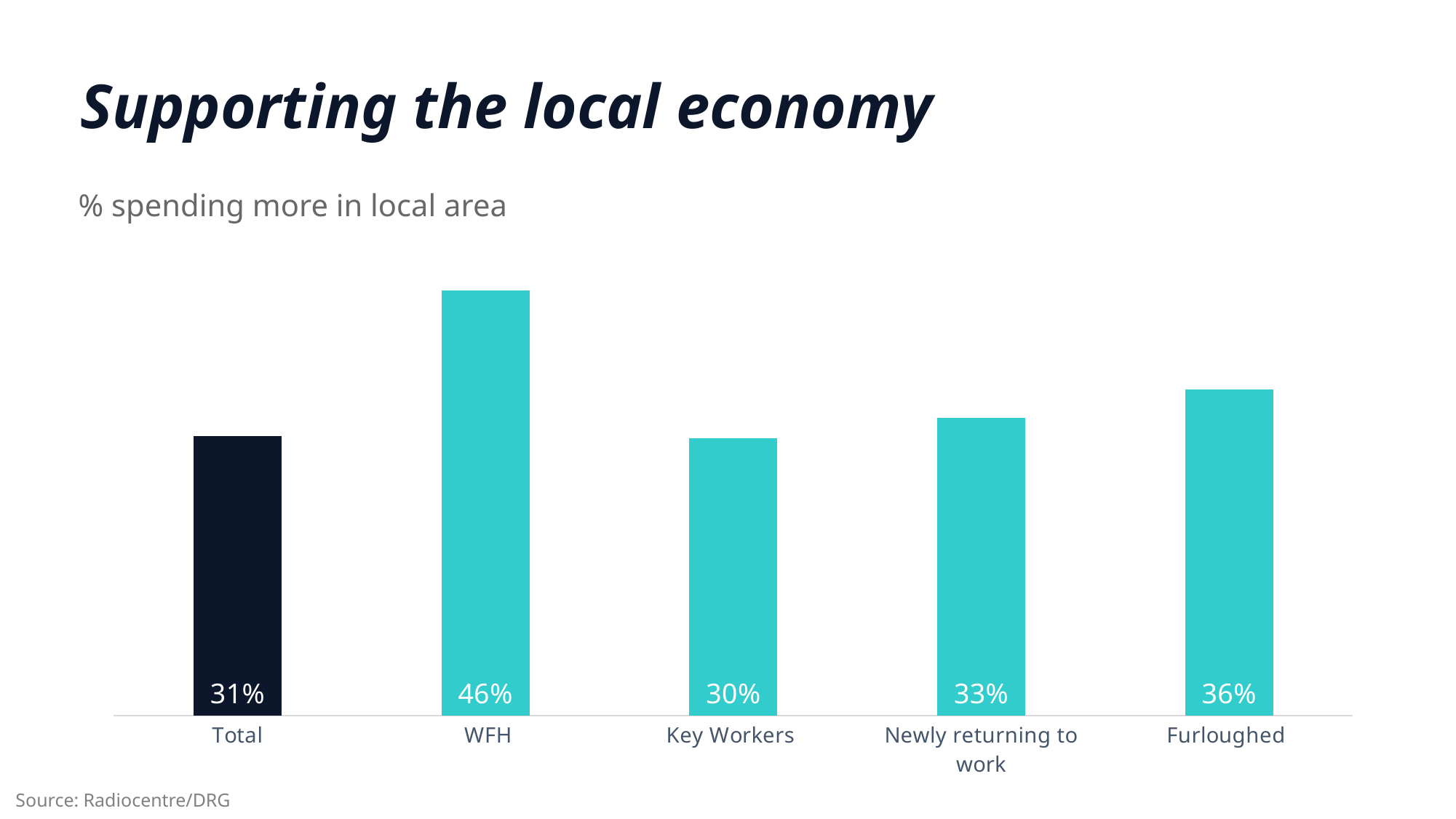
What is the value shown for Furloughed? 36% What is the difference in percentage points between WFH and Key Workers? 16 What type of chart is shown on the slide? Bar chart What is the difference in percentage points between Furloughed and Total? 5 Which is larger, the value for Furloughed or the value for Newly returning to work? Furloughed Which category has the lowest percentage spending more in the local area? Key Workers How many categories are shown on the chart? 5 What is the value shown for Newly returning to work? 33% What percentage of the Total group are spending more in their local area? 31% What is the value shown for WFH? 46% What is the value shown for Key Workers? 30% Which category has the highest percentage spending more in the local area? WFH